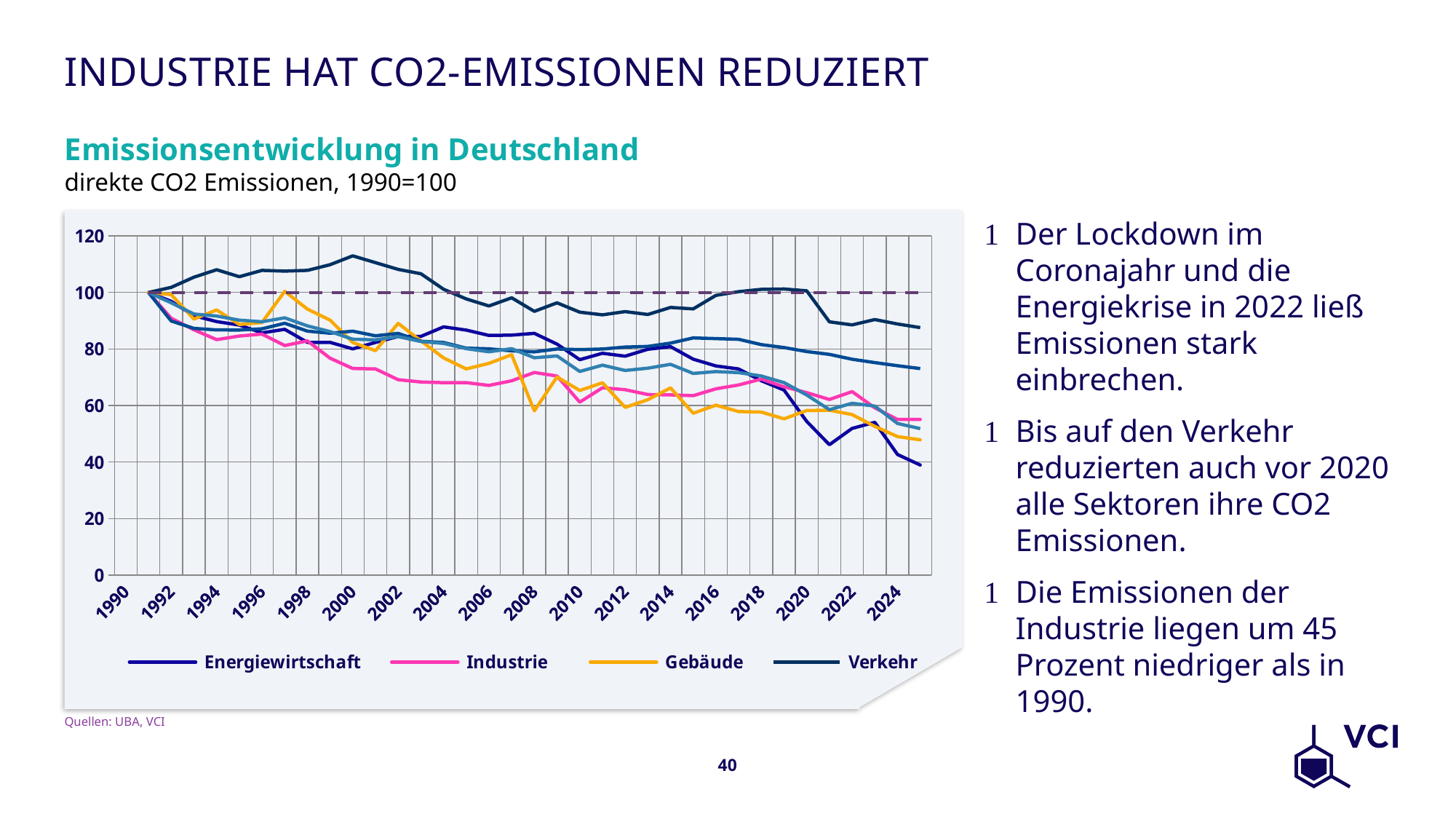
Which series has the highest value in 2024? Verkehr Which is larger in 2010, the value for Verkehr or the value for Industrie? Verkehr Is the value for Verkehr in 2024 greater or less than 80? greater How many series does the chart legend list? 4 What is the title of the chart? Emissionsentwicklung in Deutschland Is the value for Energiewirtschaft in 2024 greater or less than 60? less Does the Industrie series rise or fall from 1990 to 2024? fall Is the value for Gebäude in 2024 greater or less than 60? less What kind of chart is shown on the slide? line chart What is the index value of all series in 1990? 100 Which series has the lowest value in 2024? Energiewirtschaft